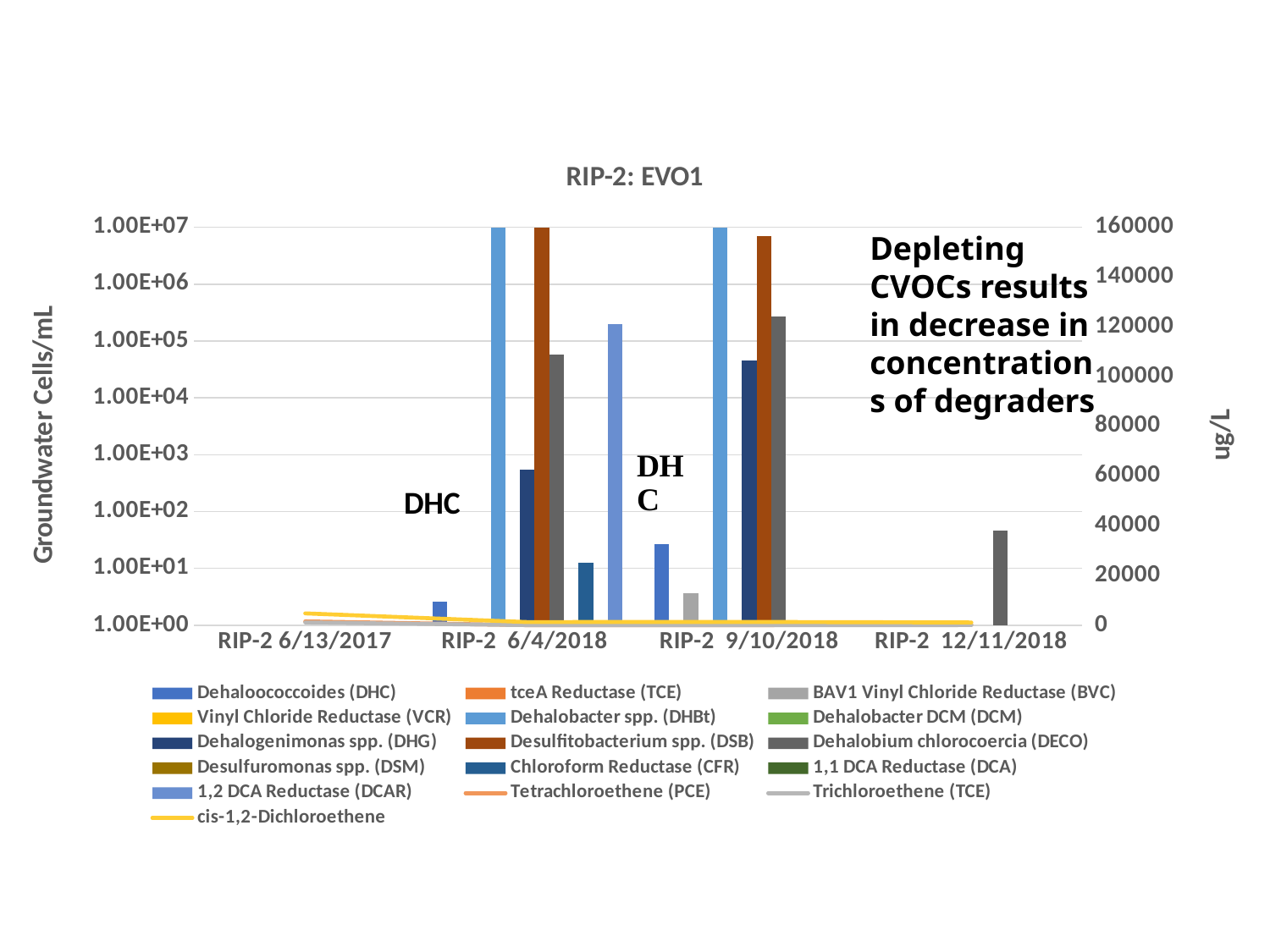
How many entries does the legend list? 16 Is the value for Dehalobacter spp. (DHBt) at RIP-2 6/4/2018 greater or less than 1.00E+06? greater Is the value for Dehaloococcoides (DHC) at RIP-2 6/4/2018 greater or less than 1.00E+01? less For Dehalobium chlorocoercia (DECO), which date has the larger value: RIP-2 9/10/2018 or RIP-2 12/11/2018? RIP-2 9/10/2018 What is the title of the chart? RIP-2: EVO1 Is the value for Dehalobium chlorocoercia (DECO) at RIP-2 12/11/2018 greater or less than 1.00E+02? less What kind of chart is used to plot the groundwater cell concentrations? bar chart How many sampling dates (categories) are shown on the x axis? 4 What is the label of the left vertical axis? Groundwater Cells/mL At RIP-2 6/4/2018, which is larger: Dehalobacter spp. (DHBt) or Dehalogenimonas spp. (DHG)? Dehalobacter spp. (DHBt)